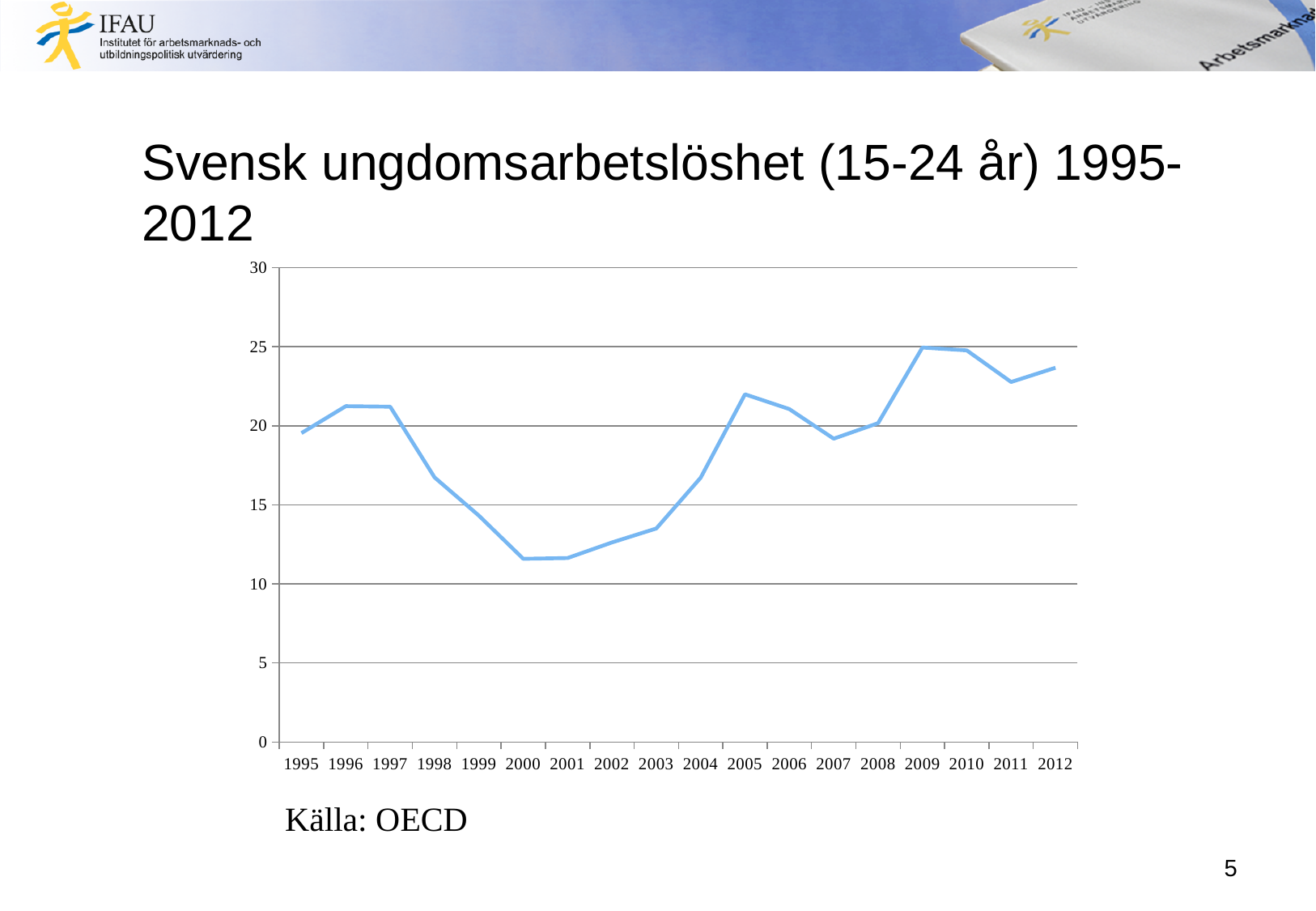
What kind of chart is shown on the slide? line chart Which year has the larger value, 2000 or 2005? 2005 Is the value for 1998 greater or less than 20? less What source is cited below the chart? OECD Do the values rise or fall from 2001 to 2005? rise Is the value for 2000 greater or less than 15? less Is the value for 2005 greater or less than 20? greater How many years are plotted along the x axis of the chart? 18 Which year has the larger value, 1995 or 2012? 2012 Do the values rise or fall from 1997 to 2000? fall